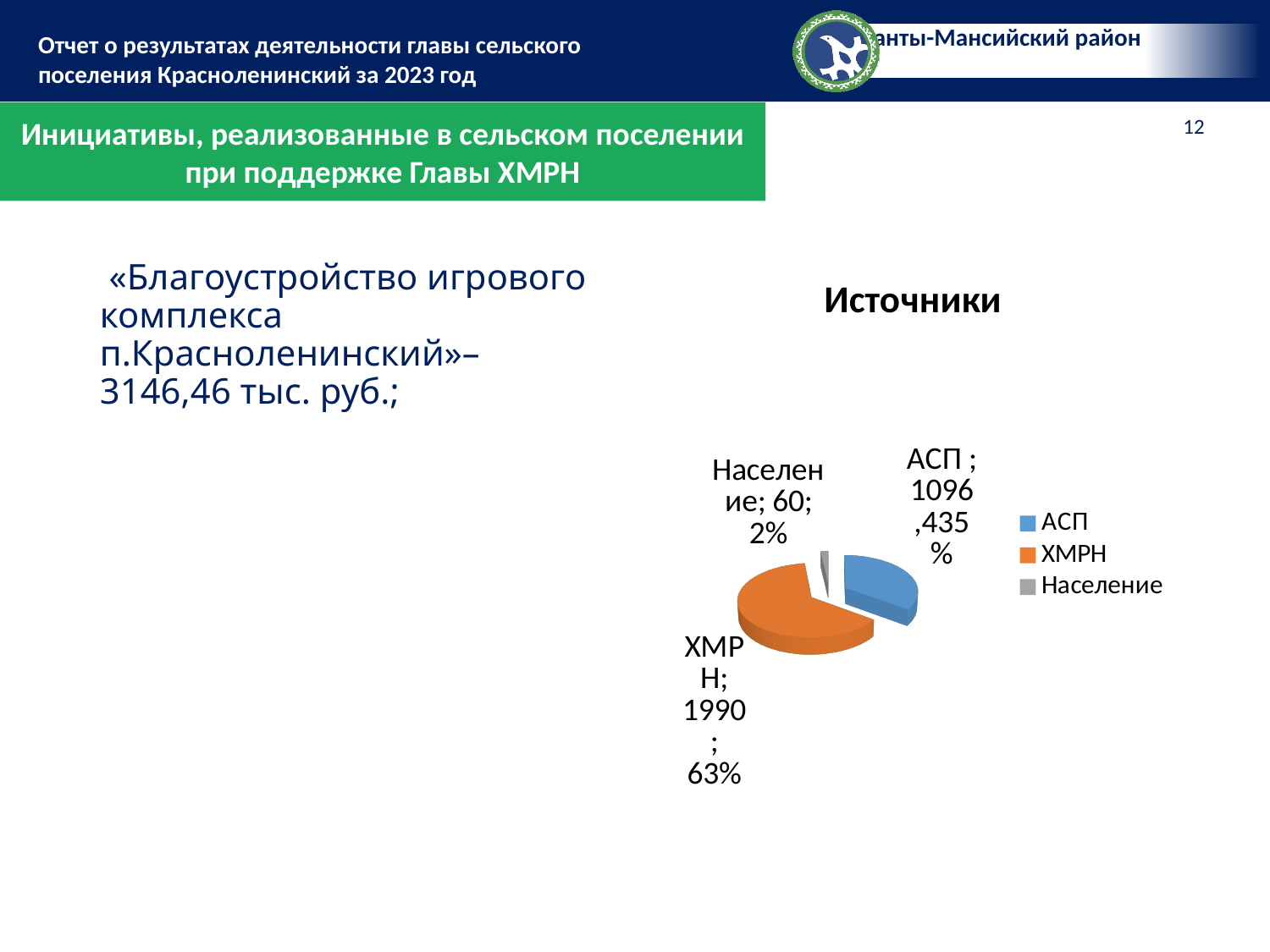
How many entries does the chart legend list? 3 What kind of chart is shown on the slide? pie chart How many slices does the pie chart have? 3 What is the title of the chart? Источники Which category has the largest slice of the pie? ХМРН What share of the pie does Население account for? 2% What is the difference between the values for ХМРН and Население? 1930 What is the value for Население in the pie chart? 60 What share of the pie does ХМРН account for? 63% What is the value for ХМРН in the pie chart? 1990 Which is larger, the value for ХМРН or the value for Население? ХМРН Which category has the smallest slice of the pie? Население